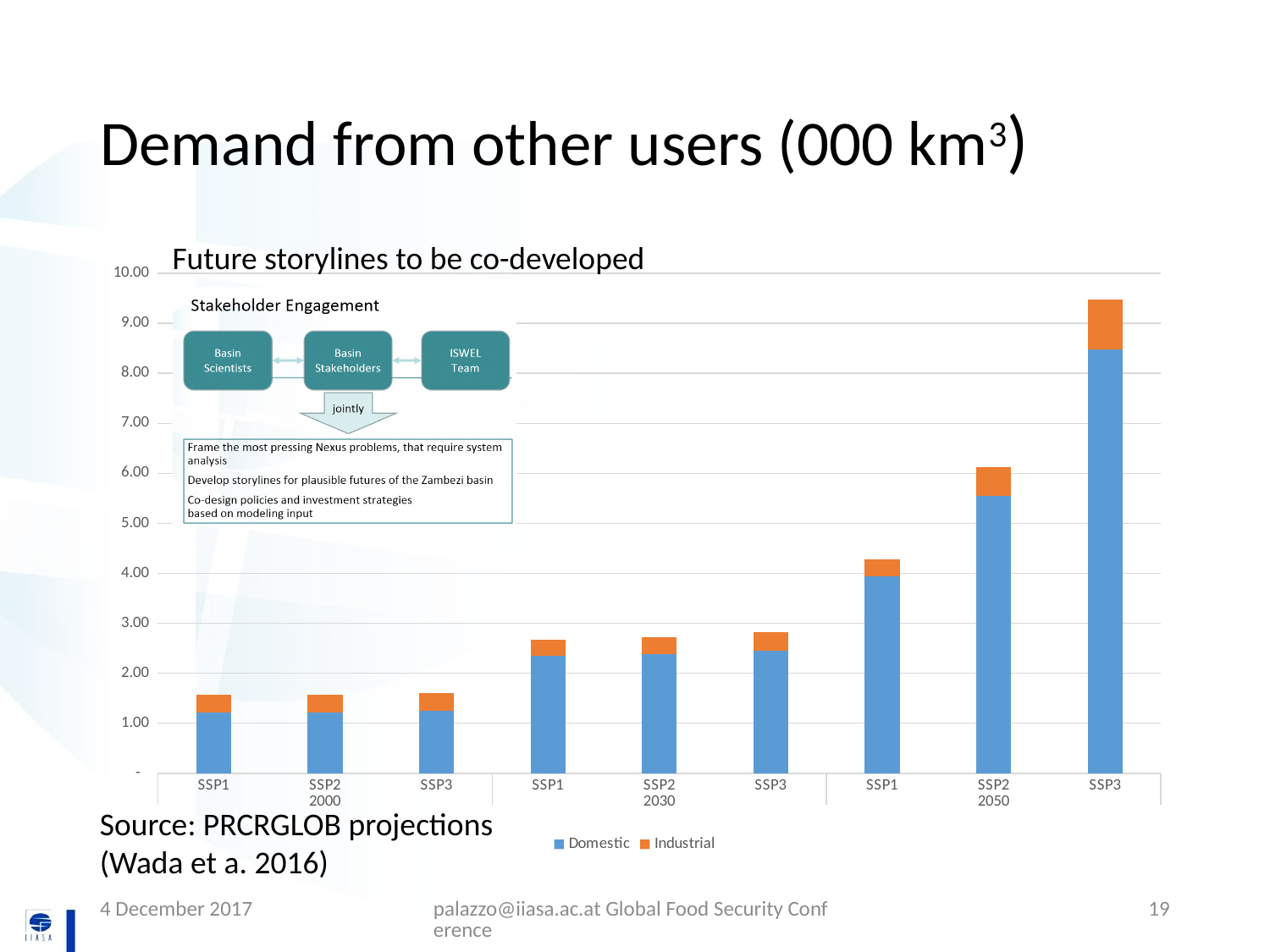
Is the total value for SSP1 in 2030 greater or less than 3.00? less Which is larger, the total for SSP2 in 2050 or the total for SSP3 in 2050? SSP3 in 2050 Which two series are listed in the chart legend? Domestic and Industrial How many bars are plotted in the chart? 9 How many series does the chart legend list? 2 Which is larger, the total for SSP1 in 2000 or the total for SSP1 in 2050? SSP1 in 2050 Is the total value for SSP3 in 2050 greater or less than 9.00? greater Is the total value for SSP2 in 2050 greater or less than 5.00? greater Which bar has the highest total demand? SSP3 in 2050 What kind of chart is shown on the slide? Stacked bar chart Do the total demand values for SSP3 rise or fall from 2000 to 2050? rise